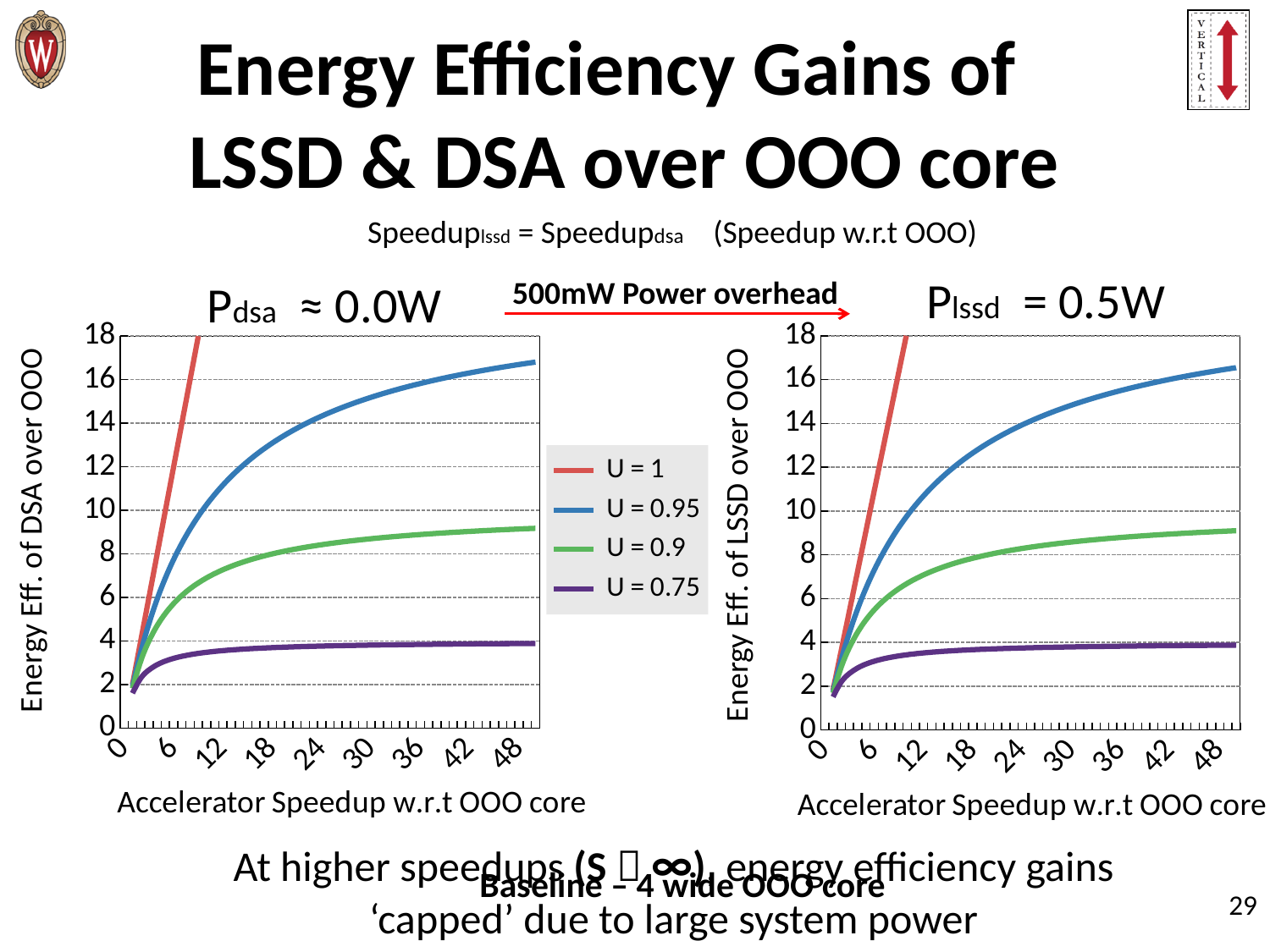
On the left chart (Energy Eff. of DSA over OOO), which series has the lowest value at an accelerator speedup of 48? U = 0.75 On the left chart (Energy Eff. of DSA over OOO), is the value of the U = 0.9 series at a speedup of 48 greater or less than 8? greater On the right chart (Energy Eff. of LSSD over OOO), is the value of the U = 0.75 series at a speedup of 48 greater or less than 6? less On the left chart (Energy Eff. of DSA over OOO), is the value of the U = 0.95 series at a speedup of 48 greater or less than 14? greater On the right chart (Energy Eff. of LSSD over OOO), which series has the lowest value at an accelerator speedup of 48? U = 0.75 On the right chart (Energy Eff. of LSSD over OOO), at a speedup of 48, which is larger: the U = 0.95 series or the U = 0.9 series? U = 0.95 What kind of chart is the left chart (Energy Eff. of DSA over OOO)? line chart What is the x-axis label of the right chart? Accelerator Speedup w.r.t OOO core What is the y-axis label of the left chart? Energy Eff. of DSA over OOO On the left chart (Energy Eff. of DSA over OOO), does the U = 0.95 series rise or fall as accelerator speedup increases? rise How many series does the legend list? 4